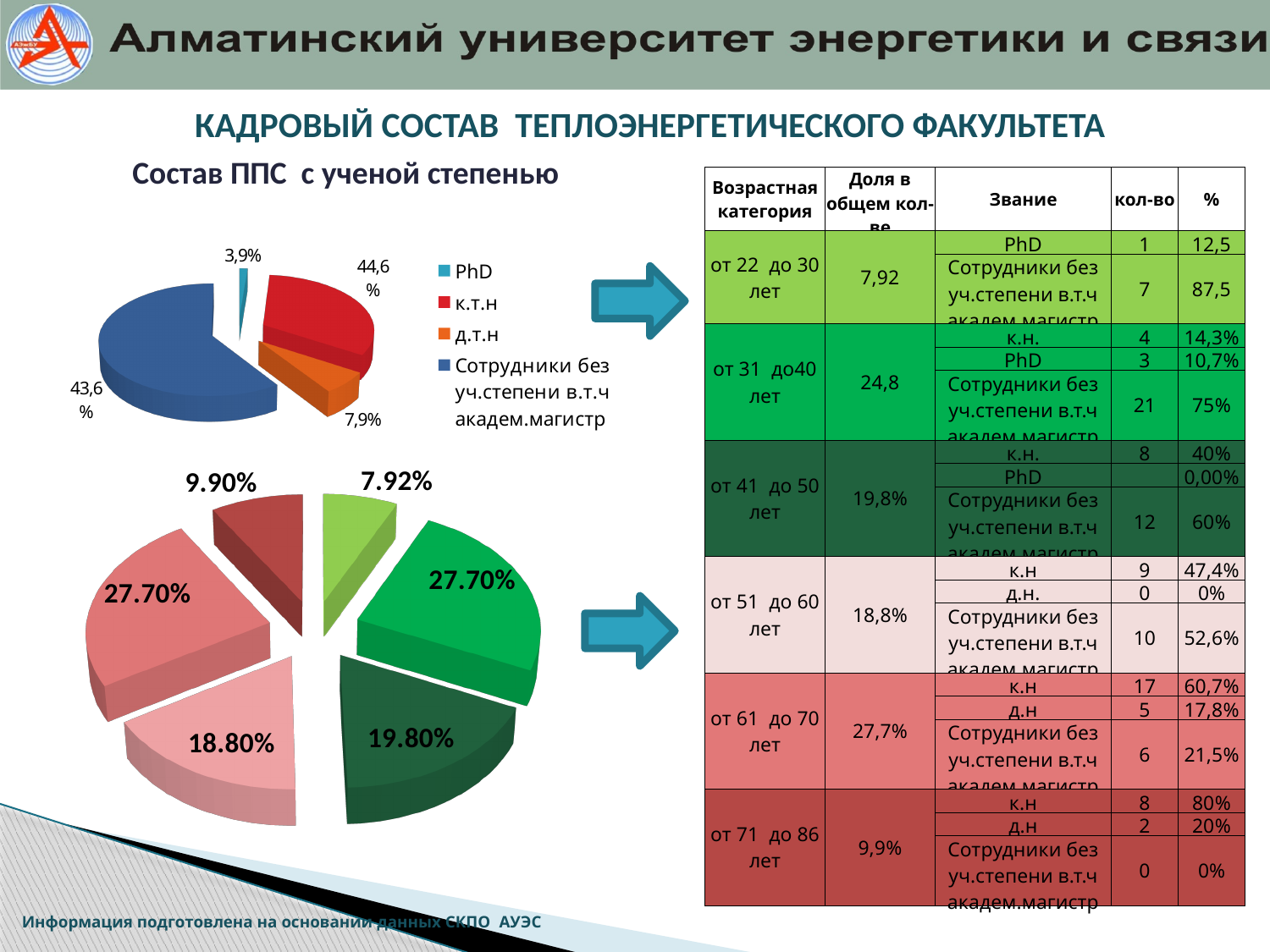
How many entries does the legend of the pie chart 'Состав ППС с ученой степенью' list? 4 In the pie chart 'Состав ППС с ученой степенью', which category has the smallest share? PhD In the pie chart 'Состав ППС с ученой степенью', how many percentage points larger is к.т.н than д.т.н? 36,7 In the pie chart 'Состав ППС с ученой степенью', which is larger: the share for PhD or the share for д.т.н? д.т.н What type of chart is the upper chart titled 'Состав ППС с ученой степенью'? Pie chart In the pie chart 'Состав ППС с ученой степенью', what share is shown for PhD? 3,9% In the pie chart 'Состав ППС с ученой степенью', what share is shown for к.т.н? 44,6% In the pie chart 'Состав ППС с ученой степенью', what share is shown for 'Сотрудники без уч.степени в.т.ч академ.магистр'? 43,6% How many slices does the lower pie chart on the left of the slide have? 6 In the pie chart 'Состав ППС с ученой степенью', what share is shown for д.т.н? 7,9% In the lower pie chart on the left of the slide, what is the smallest labelled value? 7.92%